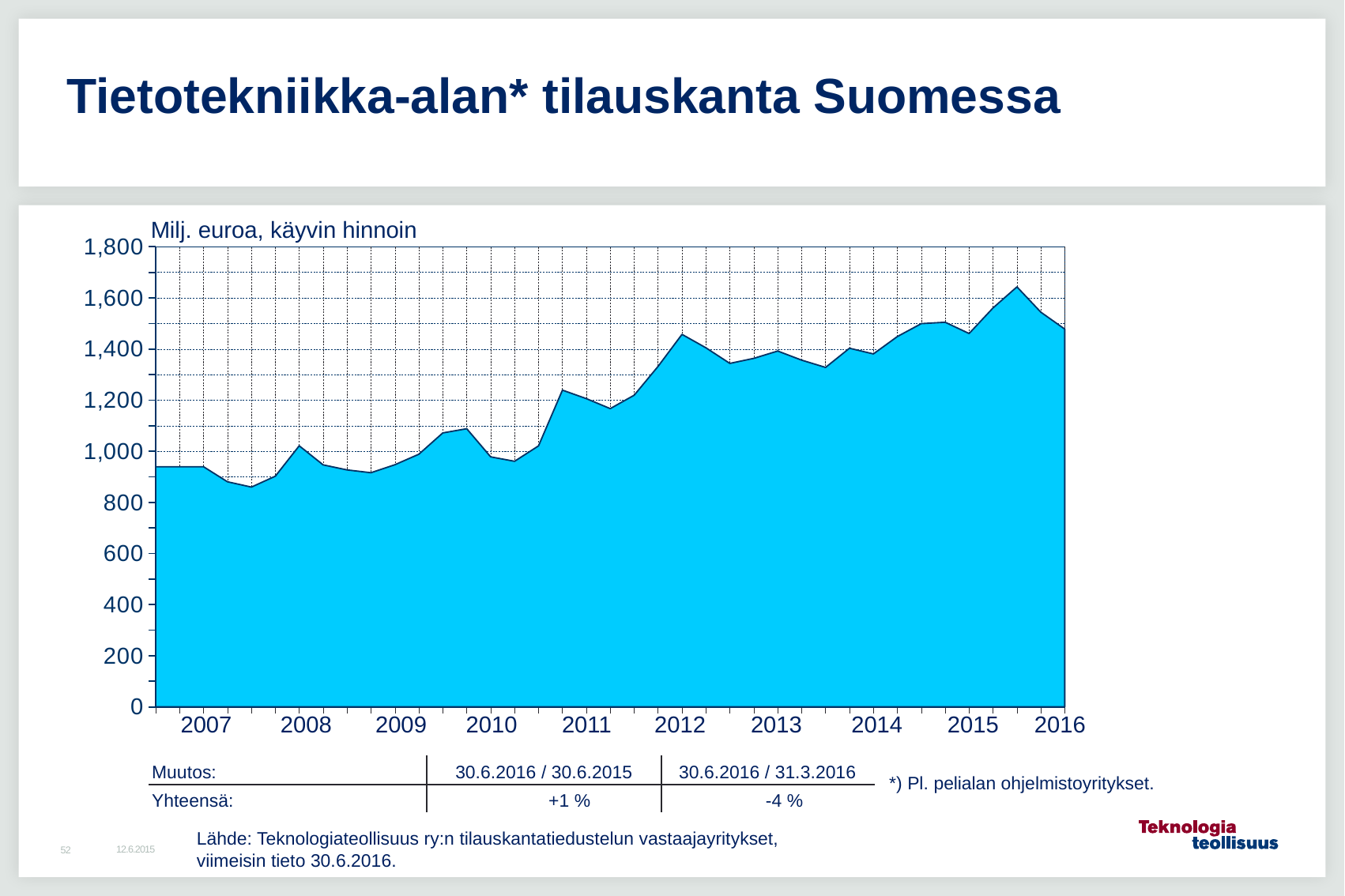
Does the order backlog overall rise or fall from 2007 to 2016? rise Is the value at the start of 2007 greater or less than 1,000? less What is the highest value shown on the y axis? 1,800 In which year does the series reach its highest value? 2015 How many year labels are shown on the x axis? 10 Is the peak value in 2015 greater or less than 1,600? greater What is the title of the slide's chart? Tietotekniikka-alan* tilauskanta Suomessa Is the value at the start of 2009 greater or less than 1,000? less What kind of chart is shown on the slide? area chart What unit is given for the values on the chart? Milj. euroa, käyvin hinnoin Which is larger, the value at the end of 2016 or the value at the start of 2007? end of 2016